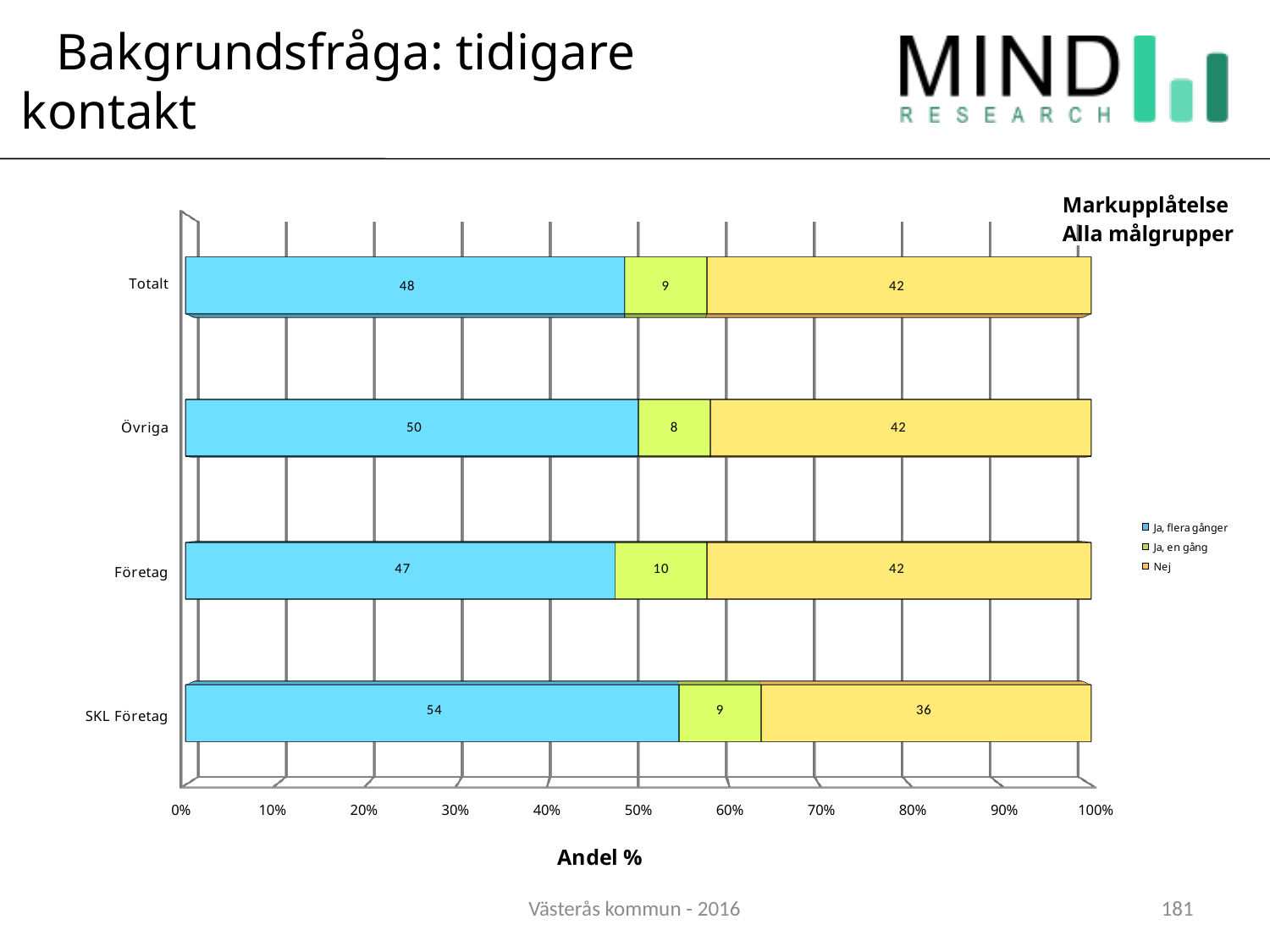
What is the value for "Ja, flera gånger" in the Totalt bar? 48 How many categories are shown on the y axis? 4 What is the label of the x axis? Andel % Which category has the lowest value for "Nej"? SKL Företag What is the total of the stacked bar for SKL Företag? 99 What is the value for "Ja, en gång" in the Företag bar? 10 How many series does the legend list? 3 Which category has the highest value for "Ja, flera gånger"? SKL Företag What is the value for "Nej" in the SKL Företag bar? 36 Which is larger: the "Ja, en gång" value for Företag or for Övriga? Företag What kind of chart is shown on the slide? Stacked bar chart What is the difference between the "Ja, flera gånger" values for SKL Företag and Företag? 7